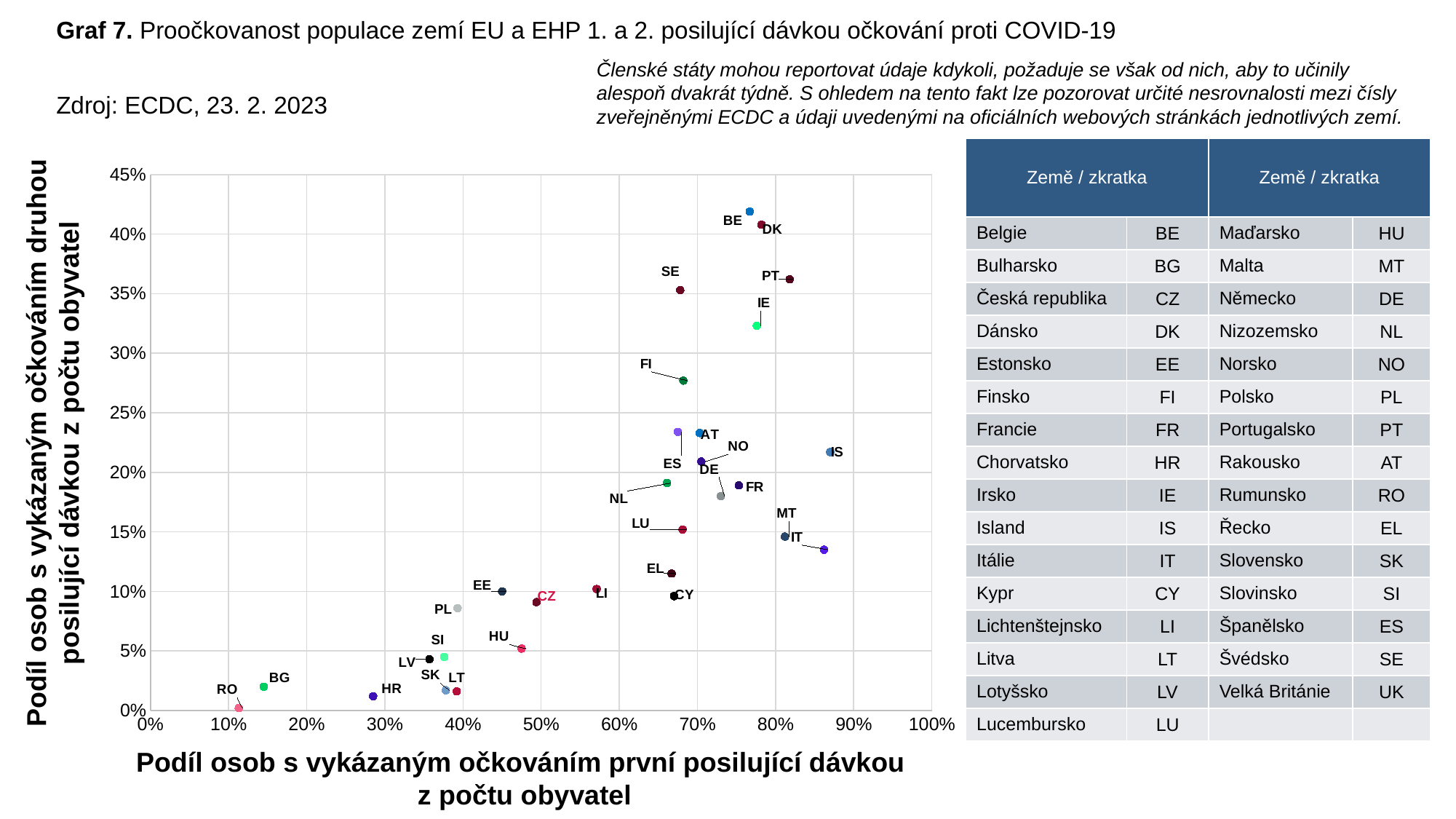
Which has a higher vertical-axis value, SE or FI? SE What is the source and date given for the chart data? ECDC, 23. 2. 2023 Which country has the lowest share of people with a second booster dose (vertical axis)? RO Which has a higher horizontal-axis value, IS or IT? IS Which country has the highest share of people with a second booster dose (vertical axis)? BE Is the vertical-axis value for CZ greater or less than 15%? less Is the horizontal-axis value for RO greater or less than 20%? less What kind of chart is shown on the slide? scatter chart Is the vertical-axis value for BE greater or less than 40%? greater Which country has the highest share of people with a first booster dose (horizontal axis)? IS